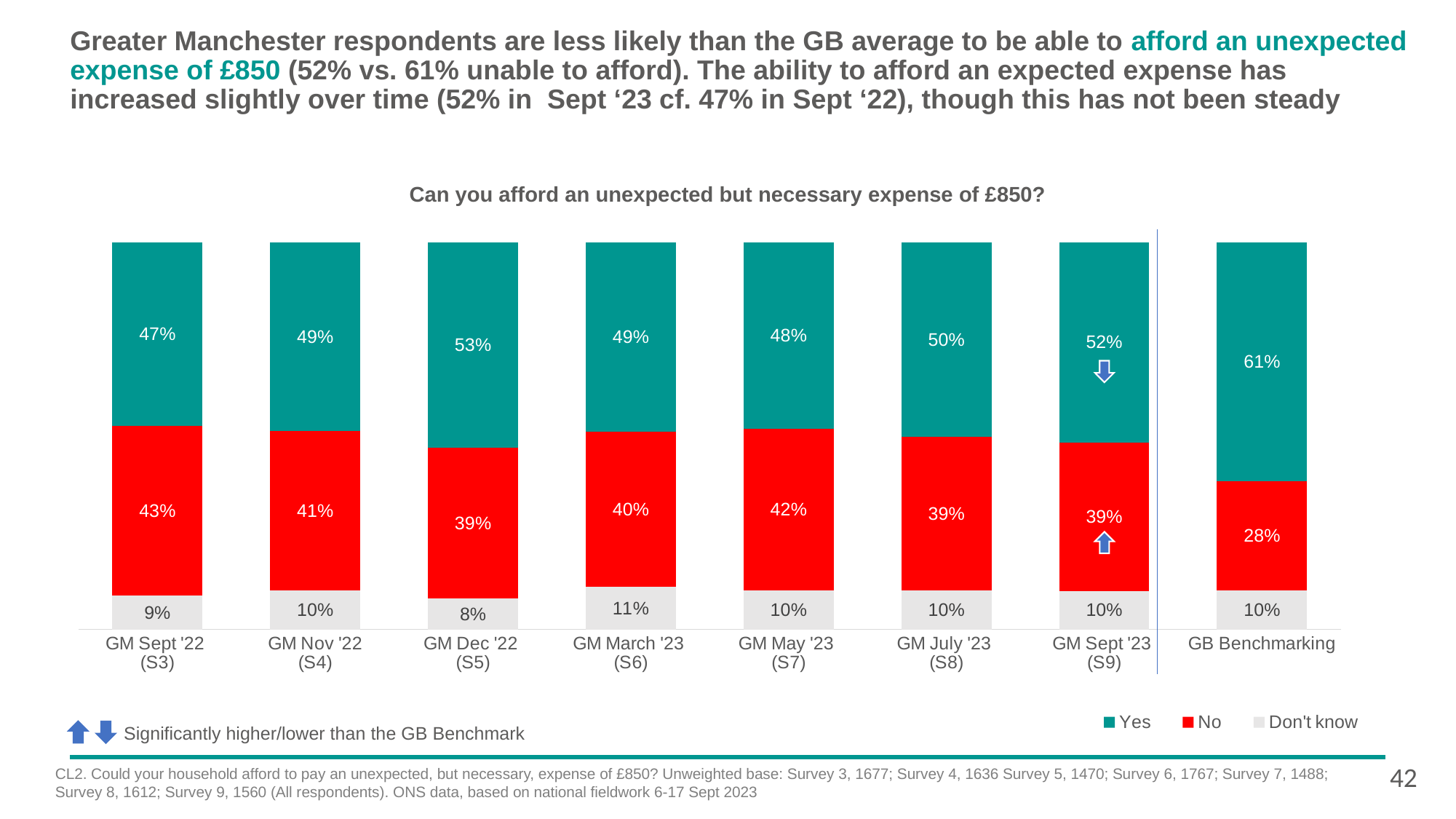
Which is larger, the No value for GM Sept '22 (S3) or for GM Dec '22 (S5)? GM Sept '22 (S3) What is the difference between the Yes values for GB Benchmarking and GM Sept '23 (S9)? 9% What is the title of the chart? Can you afford an unexpected but necessary expense of £850? How many series does the legend list? 3 What is the total of the stacked bar for GM Nov '22 (S4)? 100% Which category has the lowest Don't know value? GM Dec '22 (S5) Which category has the highest Yes value? GB Benchmarking What kind of chart is shown? Stacked bar chart What is the No value for GB Benchmarking? 28% What percentage of GM Sept '23 (S9) respondents answered Yes? 52% What is the Don't know value for GM March '23 (S6)? 11% How many categories are shown on the x axis? 8